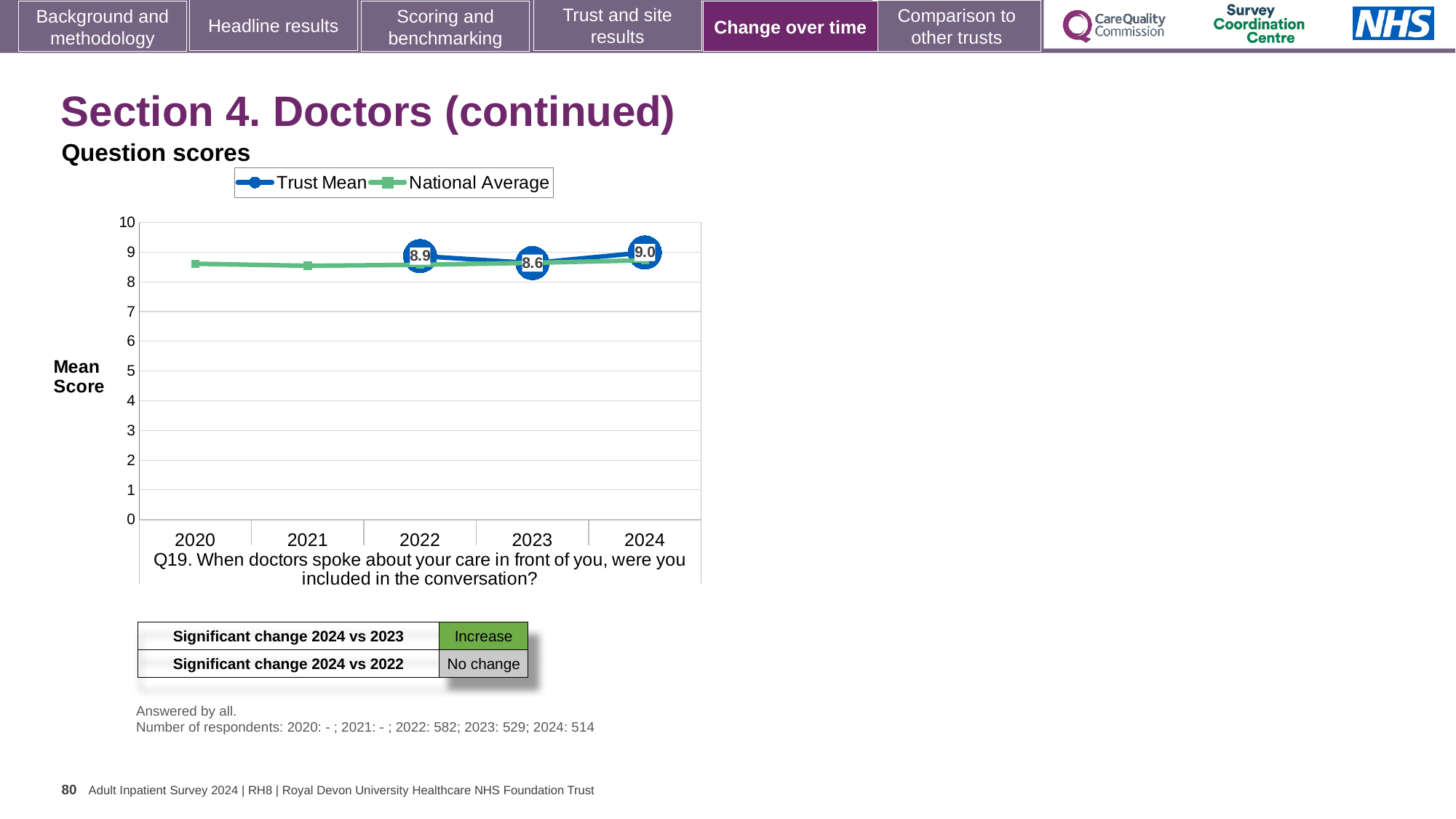
In which year is the Trust Mean score highest? 2024 What kind of chart is shown on the slide? Line chart What is the difference between the Trust Mean scores for 2024 and 2023? 0.4 In which year is the Trust Mean score lowest? 2023 Which series is drawn in green? National Average Which is larger, the Trust Mean score for 2022 or for 2023? 2022 Is the National Average score for 2020 greater or less than 8? greater What is the Trust Mean score for 2024? 9.0 What is the Trust Mean score for 2022? 8.9 How many series does the legend list? 2 How many years are shown on the x axis? 5 What is the Trust Mean score for 2023? 8.6